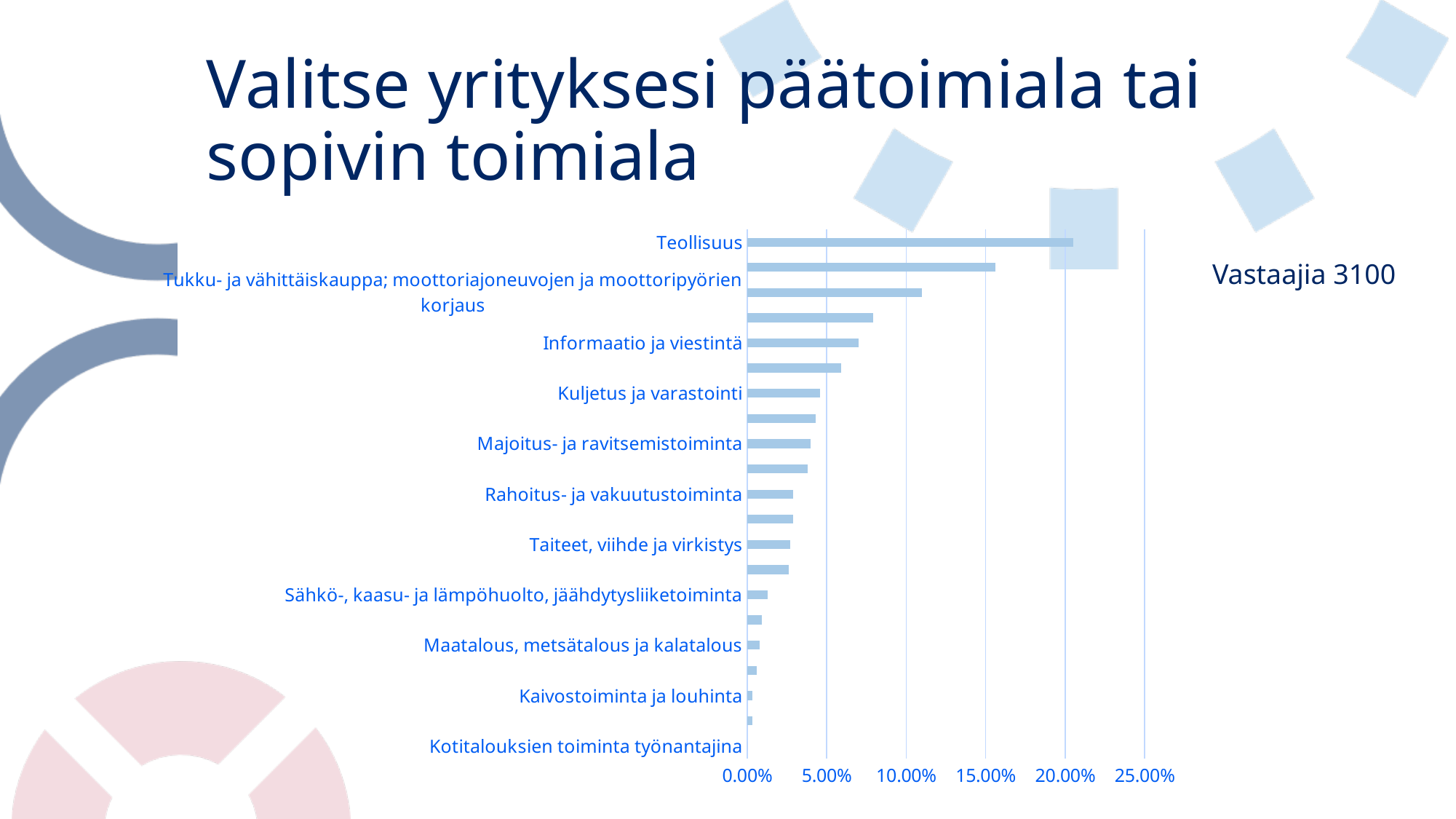
Which has a larger value, Kuljetus ja varastointi or Maatalous, metsätalous ja kalatalous? Kuljetus ja varastointi How many respondents (Vastaajia) does the slide state? 3100 Is the value for Kuljetus ja varastointi greater or less than 10.00%? less What kind of chart is shown on the slide? bar chart Is the value for Informaatio ja viestintä greater or less than 10.00%? less Is the value for Teollisuus greater or less than 15.00%? greater Do the bar values increase or decrease going from the top of the chart to the bottom? decrease What is the highest value shown on the horizontal axis of the chart? 25.00% Which category has the highest value in the chart? Teollisuus Which has a larger value, Teollisuus or Informaatio ja viestintä? Teollisuus